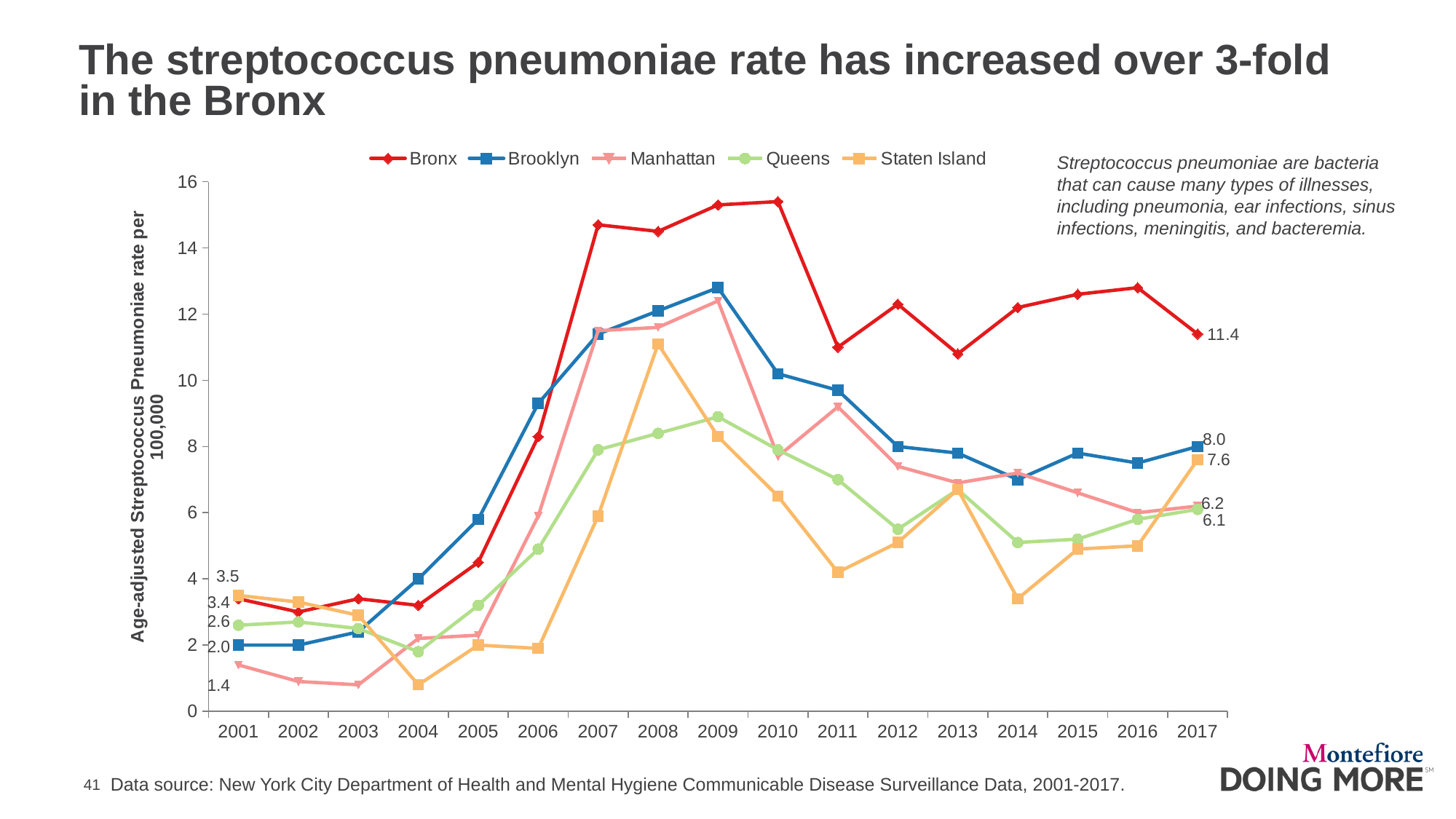
What is the age-adjusted streptococcus pneumoniae rate for the Bronx in 2017? 11.4 How many years are shown on the x axis? 17 How many boroughs are listed in the legend? 5 Which borough has the highest rate in 2017? Bronx In 2017, which is higher, the rate for Brooklyn or the rate for Queens? Brooklyn What is the rate for Brooklyn in 2001? 2.0 Which borough has the lowest rate in 2001? Manhattan What kind of chart is shown on the slide? Line chart Is the Bronx rate in 2010 greater or less than 14? greater What is the rate for Manhattan in 2001? 1.4 What is the rate for Staten Island in 2017? 7.6 By how much did the Bronx rate increase from 2001 to 2017? 8.0